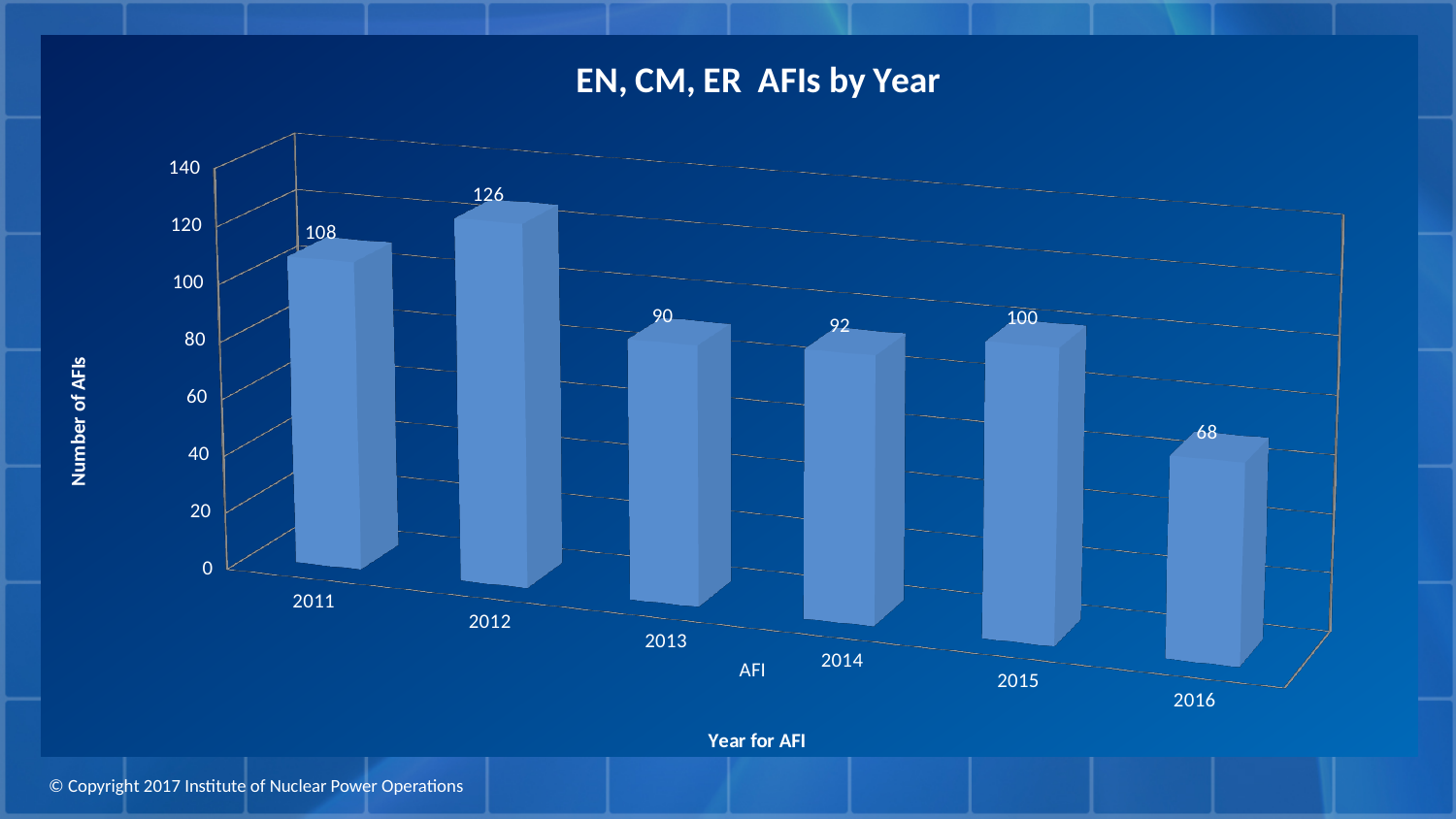
What is the title of the chart? EN, CM, ER AFIs by Year What is the difference in the number of AFIs between 2011 and 2013? 18 What is the difference in the number of AFIs between 2012 and 2016? 58 What is the number of AFIs for 2014? 92 What kind of chart is shown on the slide? Bar chart What is the number of AFIs for 2011? 108 Which year has the lowest number of AFIs? 2016 Which year has more AFIs, 2013 or 2015? 2015 What is the number of AFIs for 2016? 68 How many years are shown on the chart? 6 Which year has the highest number of AFIs? 2012 What is the label of the vertical axis? Number of AFIs